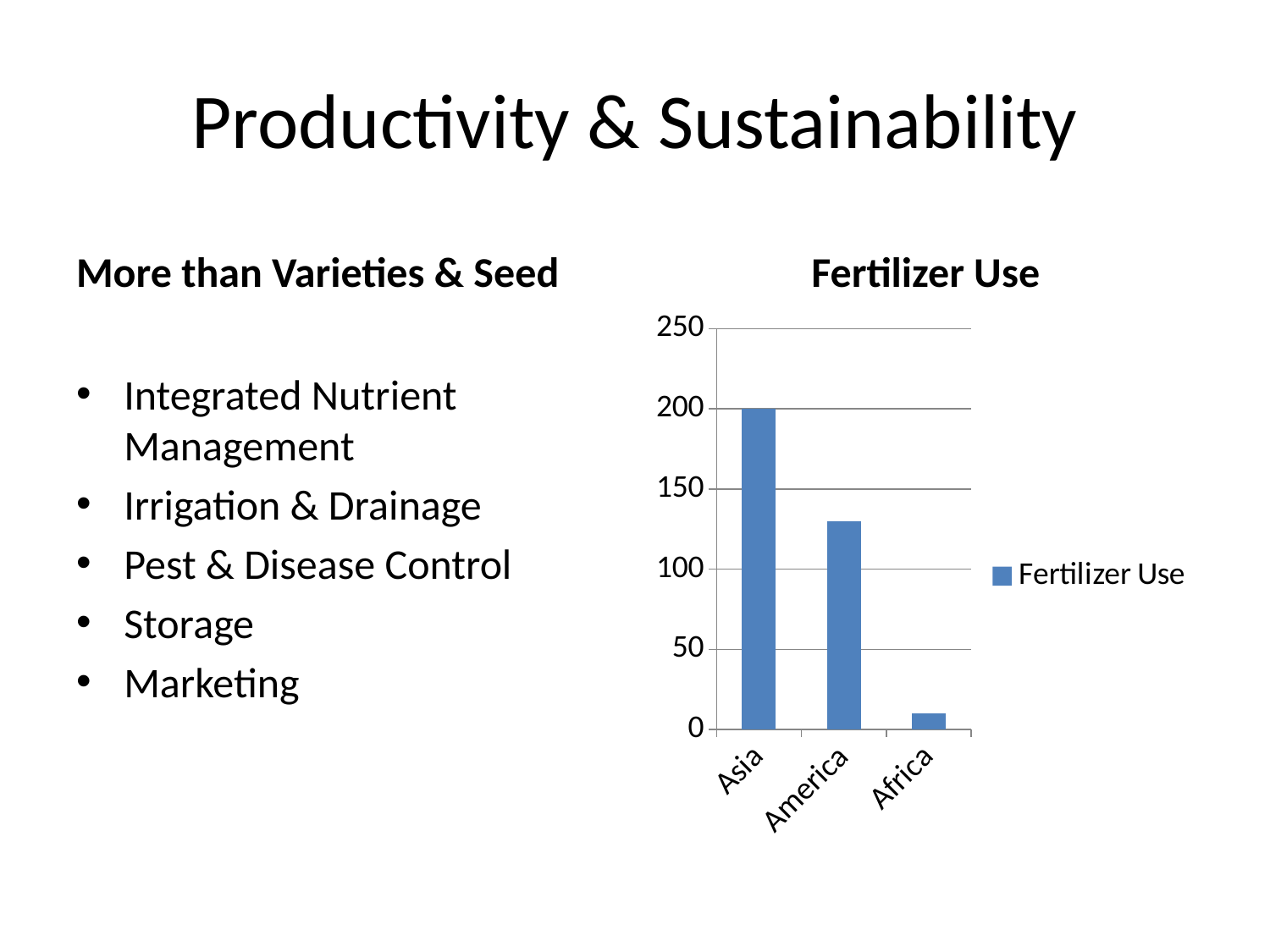
Is the fertilizer use value for America greater or less than 150? less How many series does the legend of the Fertilizer Use chart list? 1 How many categories are plotted in the Fertilizer Use chart? 3 Do the values rise or fall moving from Asia to Africa along the x axis? fall What is the fertilizer use value for Asia? 200 Is the fertilizer use value for Africa greater or less than 50? less What kind of chart is shown on the slide? bar chart Which has a larger fertilizer use value, Asia or America? Asia Which region has the highest fertilizer use in the chart? Asia What is the title of the chart on the slide? Fertilizer Use Which region has the lowest fertilizer use in the chart? Africa Is the fertilizer use value for America greater or less than 100? greater